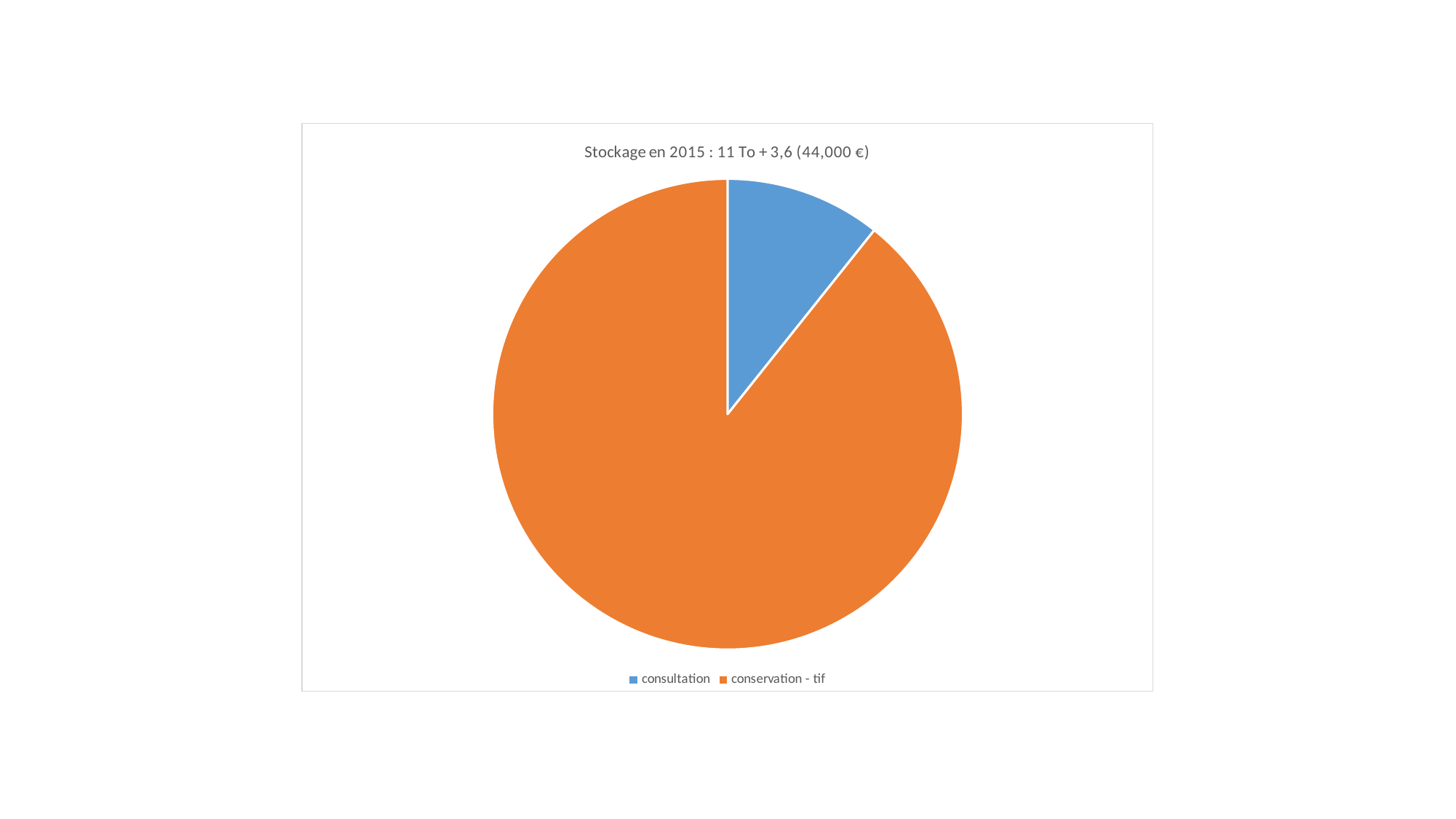
How many slices does the pie chart have? 2 Which category has the largest slice of the pie? conservation - tif How many entries does the legend list? 2 Which category has the smallest slice of the pie? consultation Which slice is larger, consultation or conservation - tif? conservation - tif What kind of chart is shown on the slide? pie chart Is the share of the pie for consultation greater or less than 25%? less Is the share of the pie for conservation - tif greater or less than 50%? greater What is the title of the chart? Stockage en 2015 : 11 To + 3,6 (44,000 €) What colour is the slice for consultation? blue